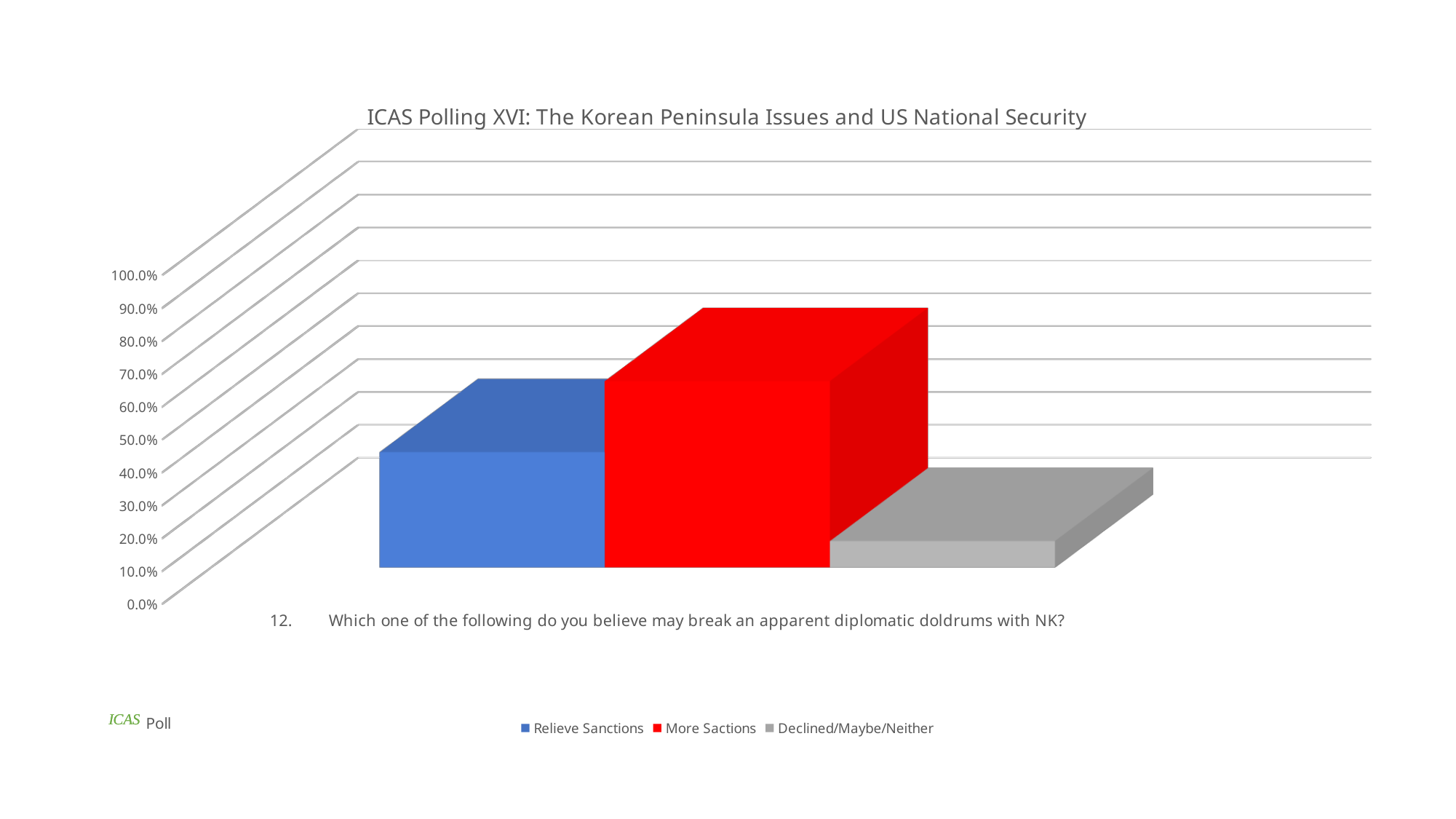
Which series has the highest value? More Sactions Which is larger, the value for Relieve Sanctions or the value for Declined/Maybe/Neither? Relieve Sanctions What is the title of the chart? ICAS Polling XVI: The Korean Peninsula Issues and US National Security How many series does the legend list? 3 Is the value for More Sactions greater or less than 50.0%? greater What colour is the bar for More Sactions? red What kind of chart is shown on the slide? bar chart Is the value for Relieve Sanctions greater or less than 20.0%? greater Which is larger, the value for Relieve Sanctions or the value for More Sactions? More Sactions Which series has the lowest value? Declined/Maybe/Neither Is the value for Relieve Sanctions greater or less than 50.0%? less